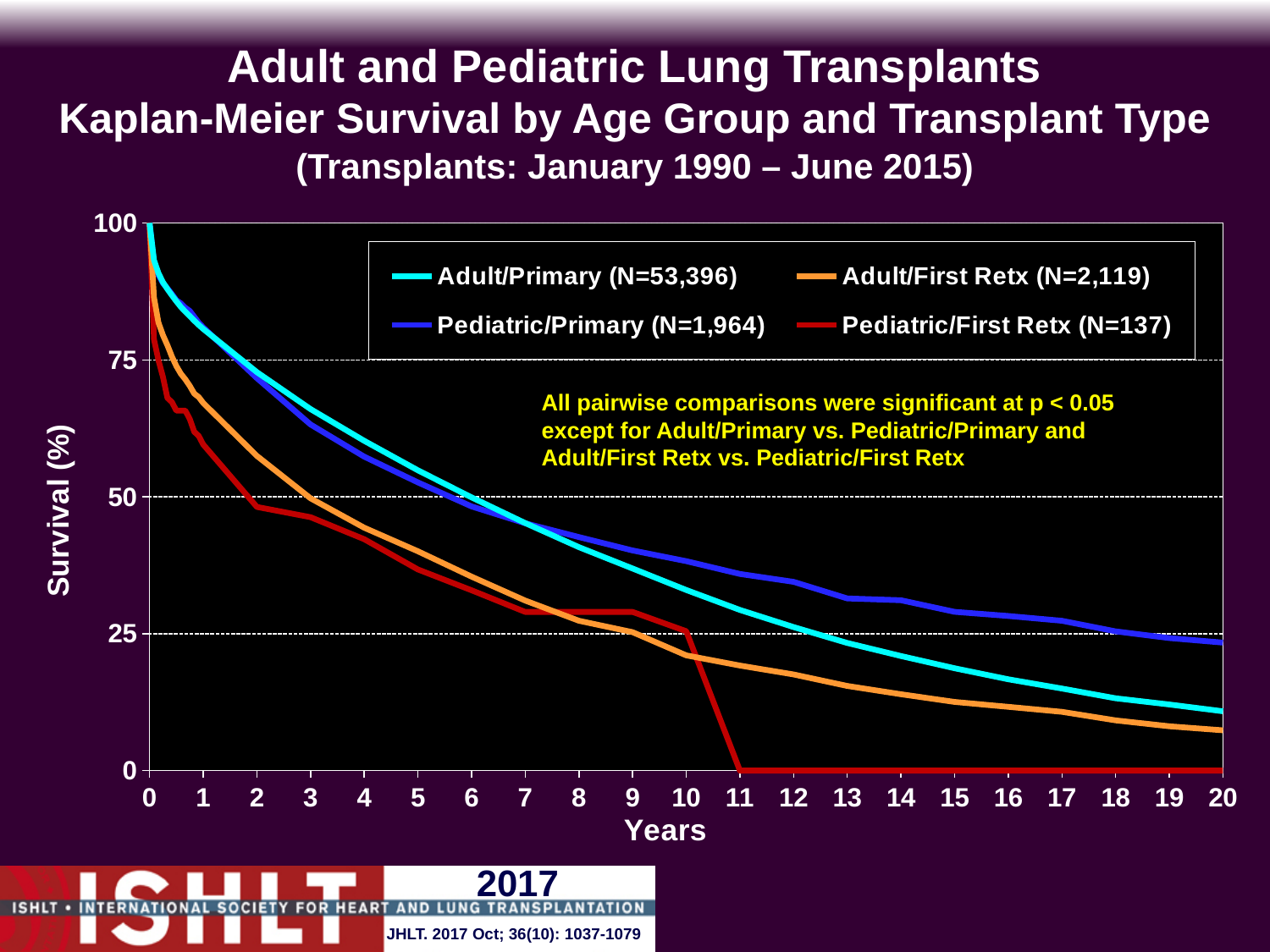
According to the legend, what is the N for the Adult/Primary series? 53,396 What is the survival value for Pediatric/First Retx at 11 years? 0 How many series does the legend list? 4 Which series has the highest survival at 20 years? Pediatric/Primary Is the survival value for Adult/Primary at 1 year greater or less than 75? greater Is the survival value for Adult/First Retx at 5 years greater or less than 50? less Do the survival curves rise or fall as the years increase? fall What kind of chart is shown on the slide? line chart Is the survival value for Adult/Primary at 20 years greater or less than 25? less What is the label of the y axis? Survival (%) At 20 years, which has higher survival: Pediatric/Primary or Adult/Primary? Pediatric/Primary